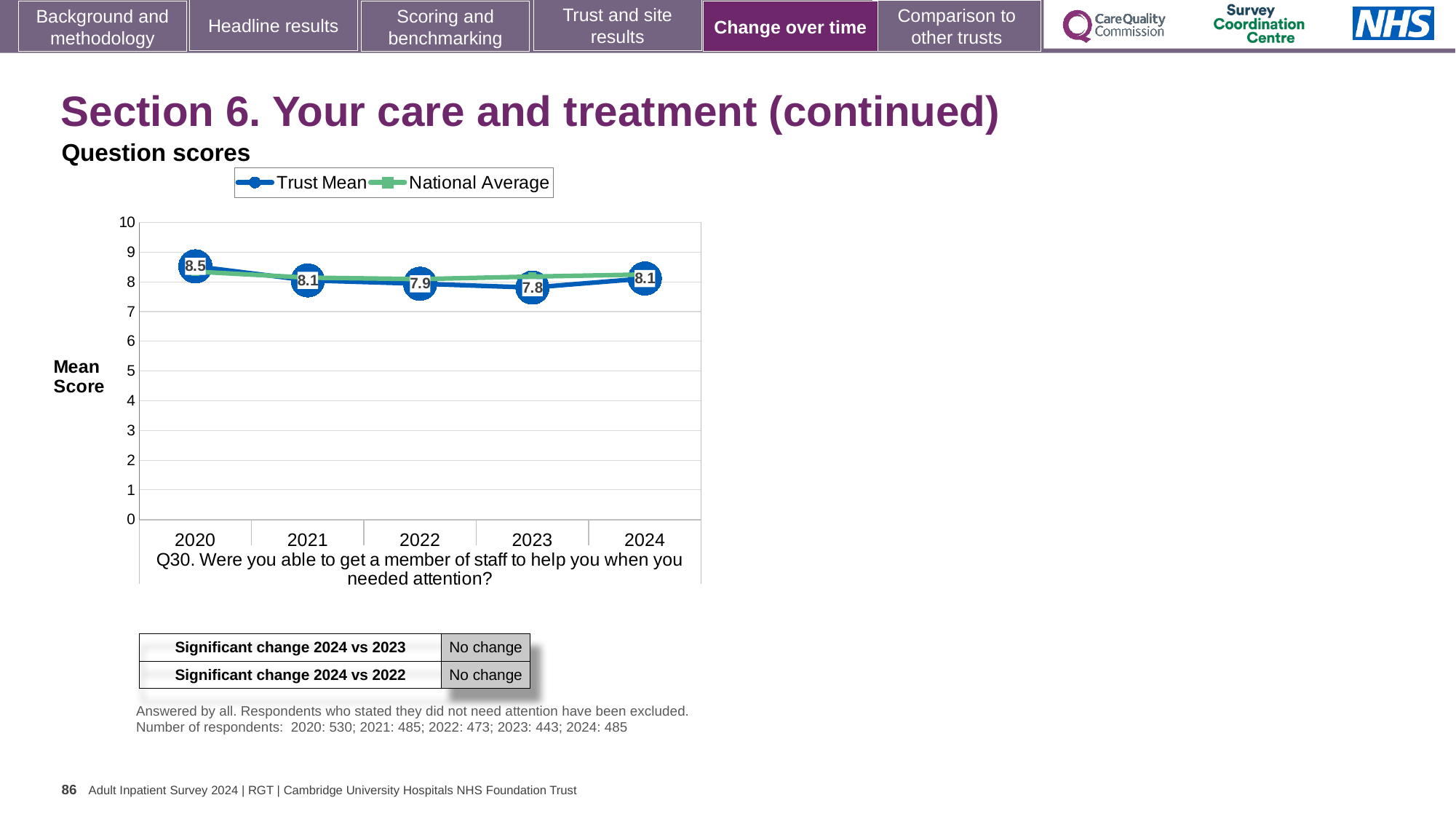
Which is larger, the Trust Mean score in 2021 or in 2022? 2021 How many series does the chart legend list? 2 What kind of chart is shown on the slide? Line chart In which year is the Trust Mean score lowest? 2023 What is the Trust Mean score for 2024? 8.1 What is the Trust Mean score for 2023? 7.8 How many years are shown on the x axis of the chart? 5 What is the difference between the Trust Mean score in 2020 and in 2023? 0.7 In which year is the Trust Mean score highest? 2020 Is the Trust Mean score for 2022 greater or less than 5? greater Which question does the chart relate to? Q30. Were you able to get a member of staff to help you when you needed attention? What is the Trust Mean score for 2020? 8.5